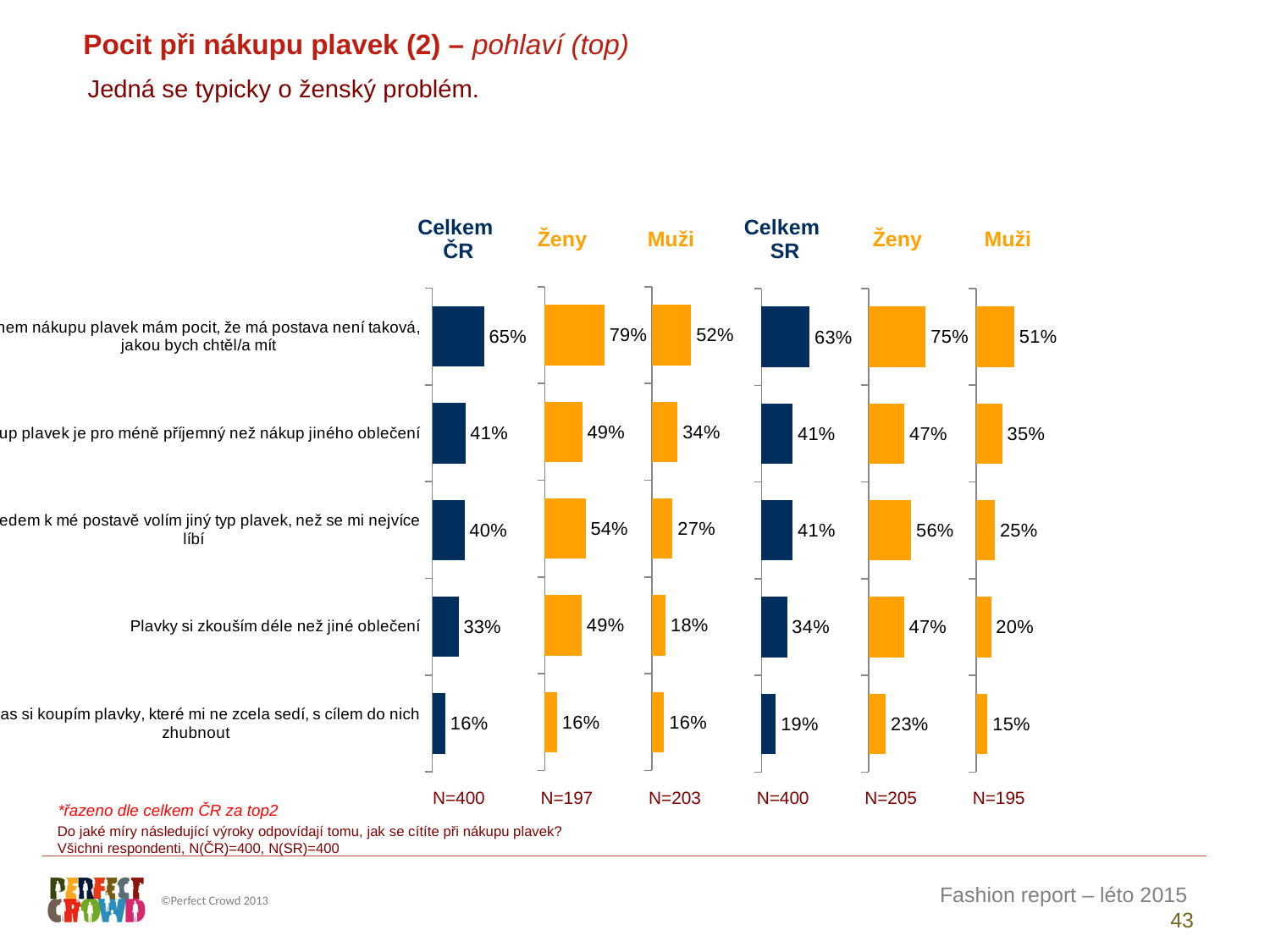
What is the sample size (N) shown under the Ženy chart in the SR group? N=205 For 'Plavky si zkouším déle než jiné oblečení', which is larger: the Ženy value in the SR group or the Muži value in the SR group? Ženy (47%) What is the difference between the Ženy and Muži values in the ČR group for 'Plavky si zkouším déle než jiné oblečení'? 31 percentage points How many statements (categories) are shown in each chart? 5 In the Muži chart of the ČR group (third chart from the left), which statement has the lowest value? The bottom statement (…si koupím plavky, které mi ne zcela sedí, s cílem do nich zhubnout) In the Celkem ČR chart, what is the value for the statement 'Plavky si zkouším déle než jiné oblečení'? 33% What type of chart is used on this slide? Bar chart In the Celkem ČR chart, which statement has the highest value? The top statement (…nákupu plavek mám pocit, že má postava není taková, jakou bych chtěl/a mít) In the Ženy chart of the ČR group (second chart from the left), what is the value for the top statement? 79% What colour are the bars in the Celkem ČR and Celkem SR charts? Dark blue In the Muži chart of the SR group (rightmost chart), what is the value for the bottom statement? 15% In the Celkem SR chart, what is the value for the statement 'Plavky si zkouším déle než jiné oblečení'? 34%